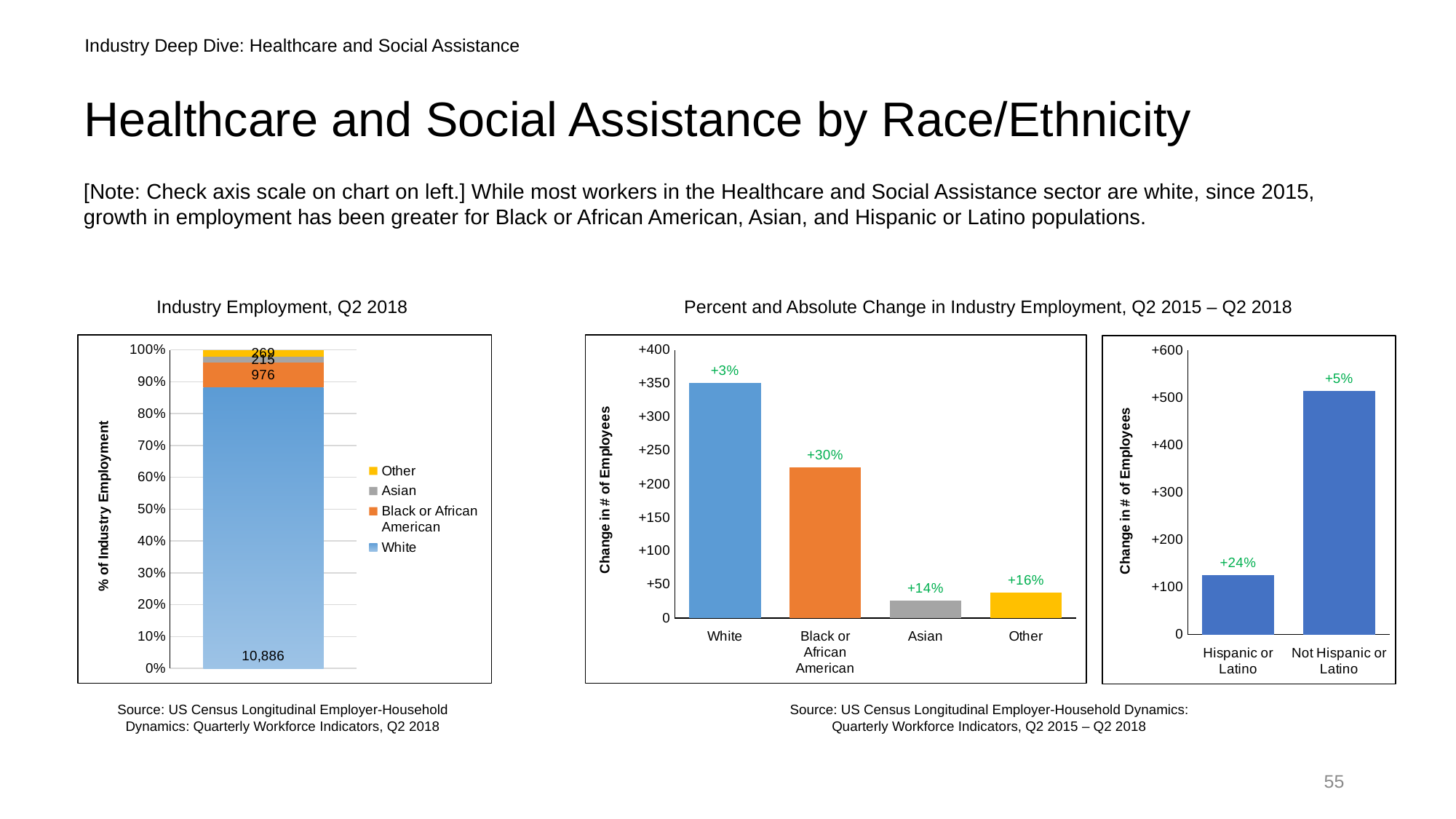
In the middle chart ('Percent and Absolute Change in Industry Employment, Q2 2015 – Q2 2018'), is the change in number of employees for White greater or less than +300? greater In the middle chart ('Percent and Absolute Change in Industry Employment, Q2 2015 – Q2 2018'), which category has the tallest bar for change in number of employees? White In the 'Industry Employment, Q2 2018' chart on the left, what value is printed on the Black or African American segment? 976 In the rightmost chart, what percent change is labelled for Hispanic or Latino? +24% In the middle chart ('Percent and Absolute Change in Industry Employment, Q2 2015 – Q2 2018'), what percent change is labelled for White? +3% In the 'Industry Employment, Q2 2018' chart on the left, what value is printed on the White segment? 10,886 In the middle chart ('Percent and Absolute Change in Industry Employment, Q2 2015 – Q2 2018'), which category has the shortest bar for change in number of employees? Asian How many series does the legend of the 'Industry Employment, Q2 2018' chart on the left list? 4 How many categories are shown on the x axis of the middle chart ('Percent and Absolute Change in Industry Employment, Q2 2015 – Q2 2018')? 4 What kind of chart is the 'Industry Employment, Q2 2018' chart on the left? Stacked bar chart In the middle chart ('Percent and Absolute Change in Industry Employment, Q2 2015 – Q2 2018'), what percent change is labelled for Black or African American? +30% In the rightmost chart, which has the larger change in number of employees, Hispanic or Latino or Not Hispanic or Latino? Not Hispanic or Latino